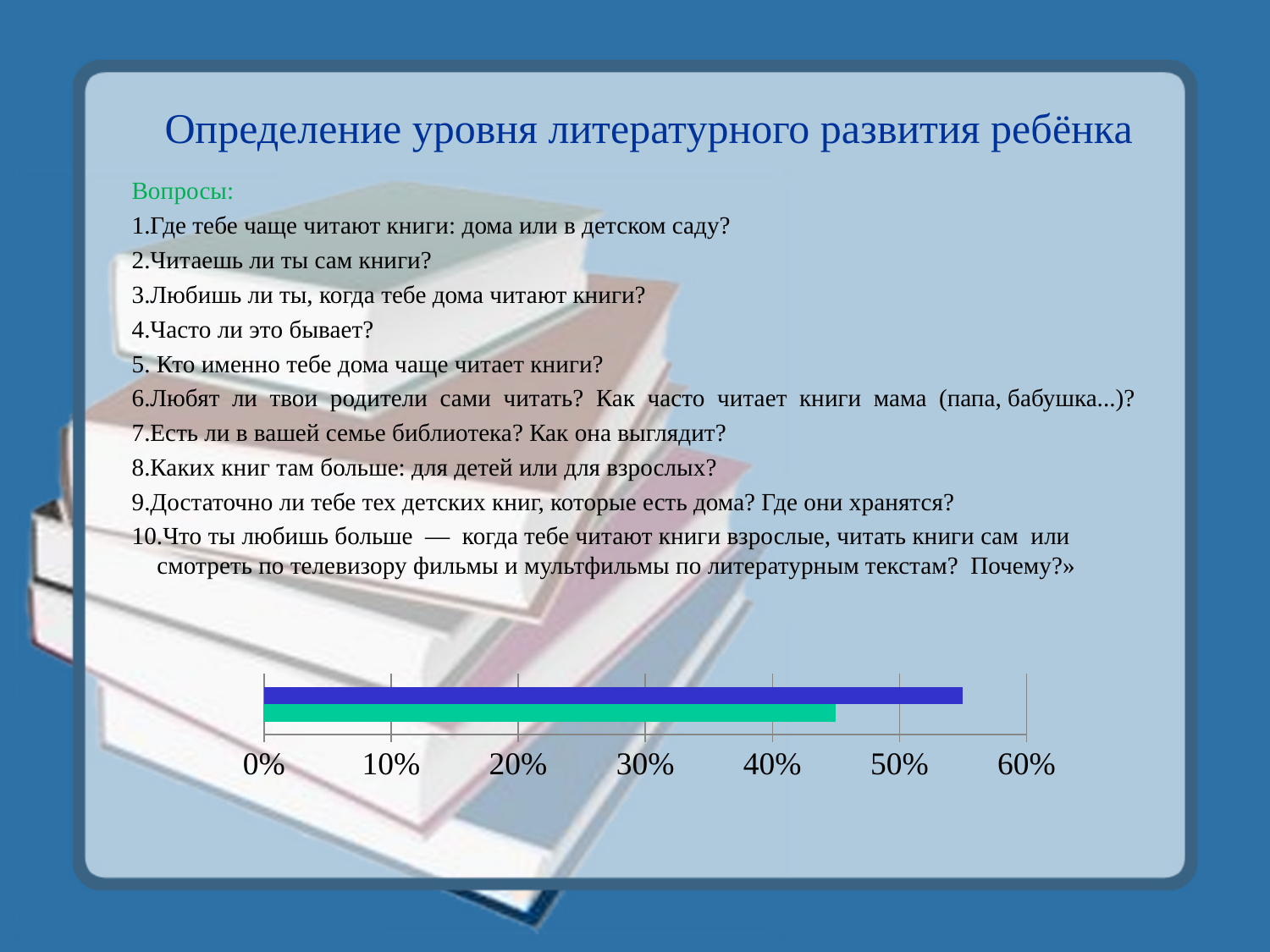
Which bar is longer, the blue bar or the green bar? the blue bar Is the value of the blue bar greater or less than 50%? greater Which bar has the lowest value in the chart? the green bar How many bars are plotted in the chart? 2 Which bar has the highest value in the chart? the blue bar What is the interval between the tick labels on the chart's horizontal axis? 10% What kind of chart is shown at the bottom of the slide? bar chart What is the highest value shown on the chart's horizontal axis? 60% Is the value of the green bar greater or less than 50%? less Is the value of the blue bar greater or less than 60%? less